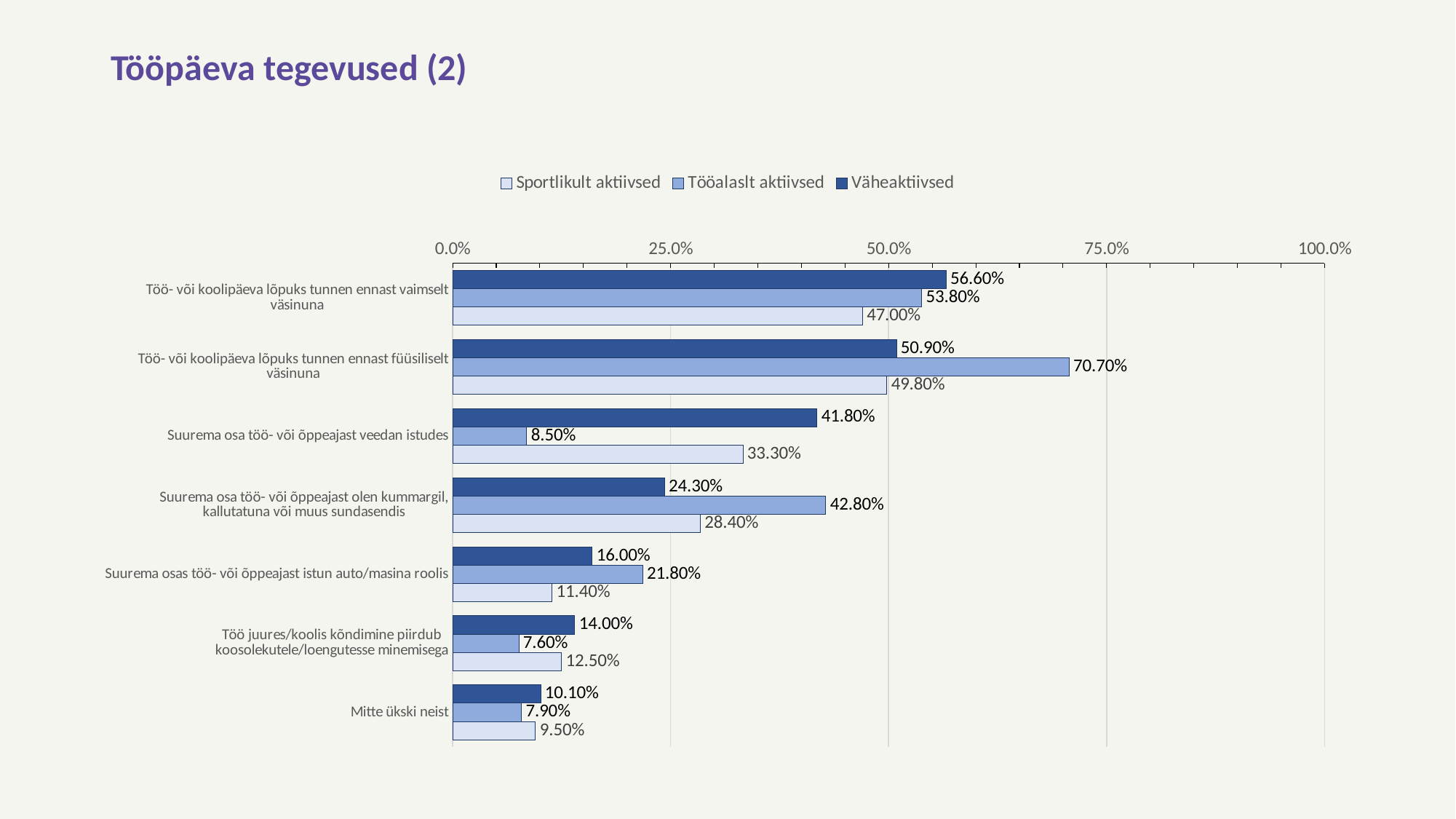
In the category 'Suurema osa töö- või õppeajast olen kummargil, kallutatuna või muus sundasendis', which series has the larger value: Väheaktiivsed or Tööalaslt aktiivsed? Tööalaslt aktiivsed What kind of chart is shown on the slide? bar chart Is the Väheaktiivsed value for 'Töö- või koolipäeva lõpuks tunnen ennast vaimselt väsinuna' greater or less than 50.0%? greater What is the title of the slide? Tööpäeva tegevused (2) How many categories are shown on the chart? 7 Which category has the lowest value for the Väheaktiivsed series? Mitte ükski neist How many series does the legend list? 3 What is the value for Väheaktiivsed in the category 'Suurema osa töö- või õppeajast veedan istudes'? 41.80% Which category has the highest value for the Tööalaslt aktiivsed series? Töö- või koolipäeva lõpuks tunnen ennast füüsiliselt väsinuna What is the value for Sportlikult aktiivsed in the category 'Mitte ükski neist'? 9.50% What is the value for Tööalaslt aktiivsed in the category 'Töö- või koolipäeva lõpuks tunnen ennast füüsiliselt väsinuna'? 70.70% What is the difference between the Tööalaslt aktiivsed and Sportlikult aktiivsed values in the category 'Suurema osa töö- või õppeajast veedan istudes'? 24.80%